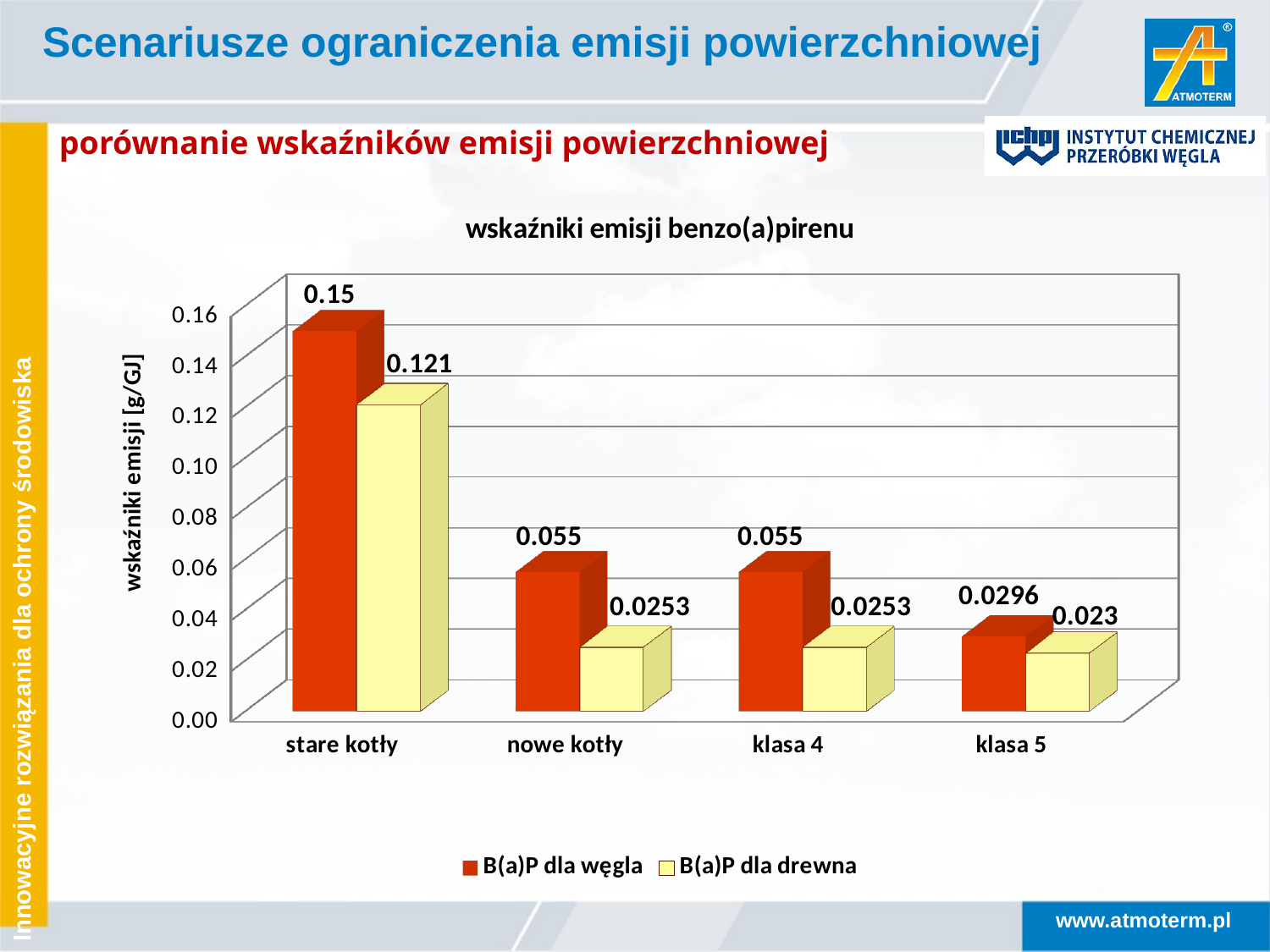
What is the title of the chart? wskaźniki emisji benzo(a)pirenu What is the difference between B(a)P dla węgla and B(a)P dla drewna for nowe kotły? 0.0297 What is the value of B(a)P dla drewna for klasa 5? 0.023 What kind of chart is shown? bar chart Which category has the lowest value for B(a)P dla drewna? klasa 5 Which category has the highest value for B(a)P dla węgla? stare kotły How many categories are shown on the x axis? 4 What is the value of B(a)P dla węgla for klasa 5? 0.0296 What is the value of B(a)P dla węgla for stare kotły? 0.15 What is the value of B(a)P dla drewna for stare kotły? 0.121 Which is larger for klasa 4: B(a)P dla węgla or B(a)P dla drewna? B(a)P dla węgla How many series does the legend list? 2